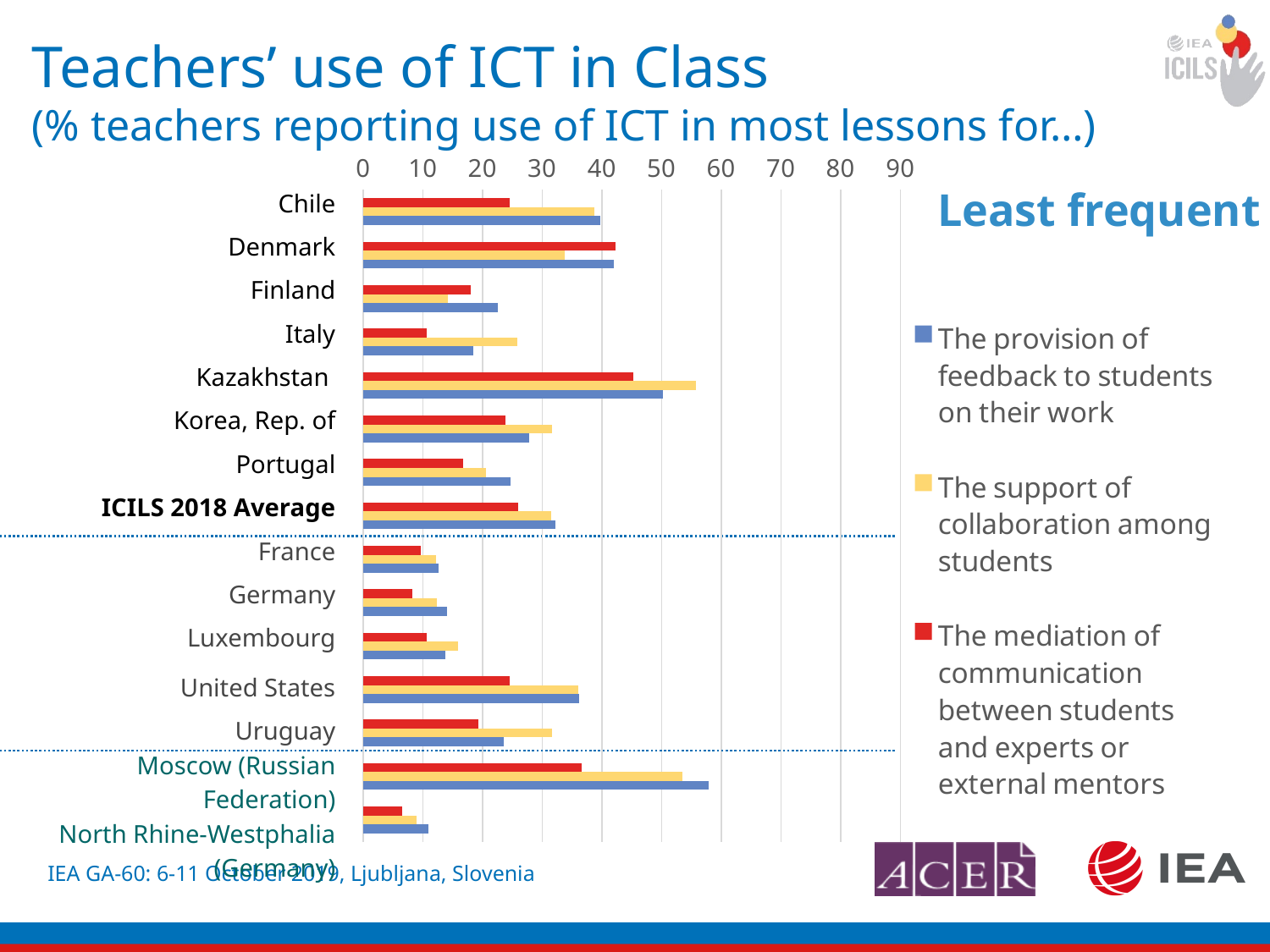
Which is larger: the value for Chile or for Finland for 'The provision of feedback to students on their work'? Chile Which category has the highest value for 'The provision of feedback to students on their work'? Moscow (Russian Federation) Which category has the lowest value for 'The provision of feedback to students on their work'? North Rhine-Westphalia (Germany) For Italy, which is larger: 'The support of collaboration among students' or 'The mediation of communication between students and experts or external mentors'? The support of collaboration among students Is the value for Kazakhstan for 'The support of collaboration among students' greater or less than 50? greater What colour represents 'The mediation of communication between students and experts or external mentors' in the legend? red How many series does the legend list? 3 What is the title of the slide's chart? Teachers' use of ICT in Class Is the value for Moscow (Russian Federation) for 'The provision of feedback to students on their work' greater or less than 50? greater What kind of chart is shown on the slide? bar chart Is the value for Finland for 'The provision of feedback to students on their work' greater or less than 30? less How many categories (countries/regions including the ICILS 2018 Average) are plotted on the chart? 15